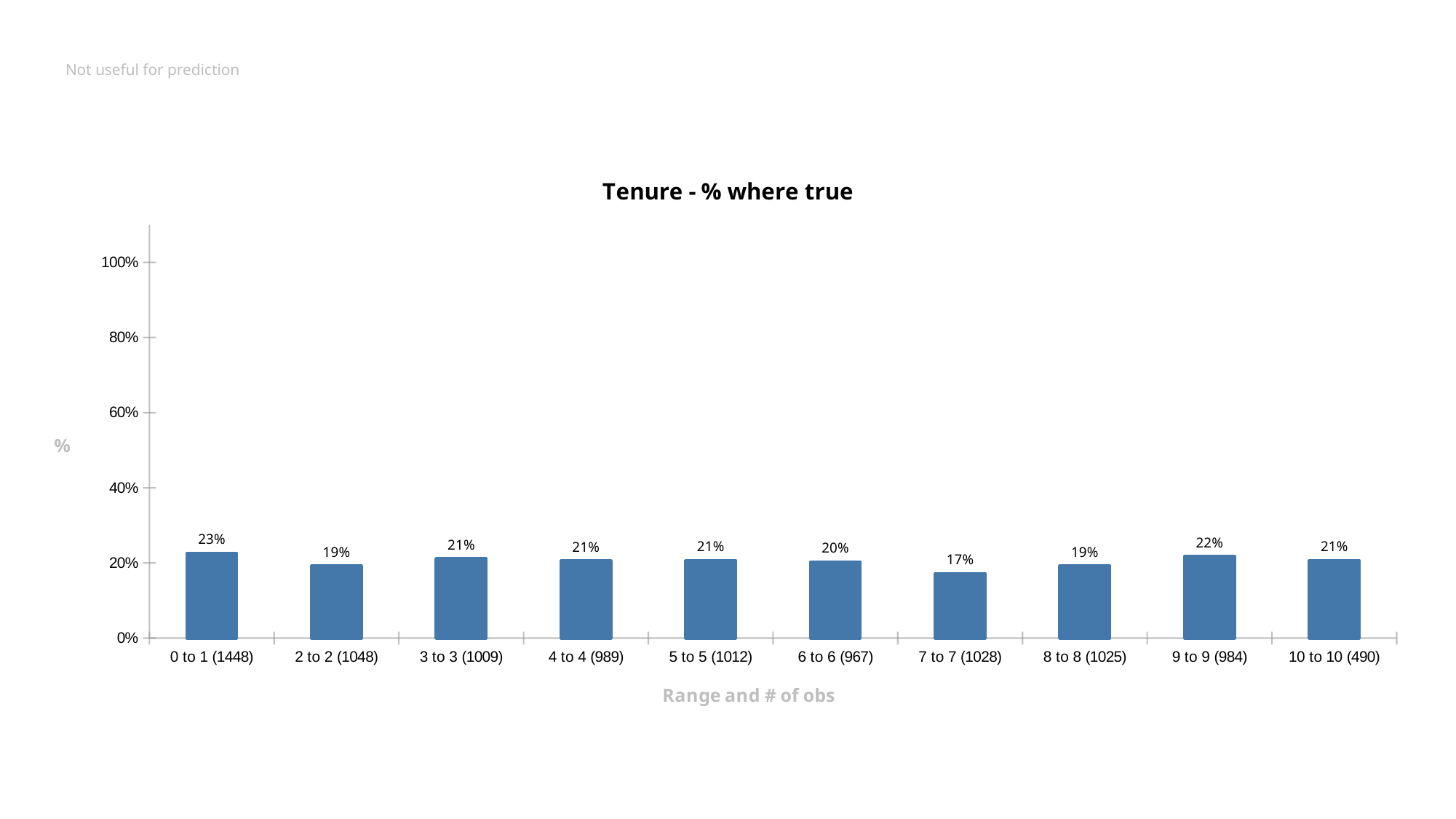
What is the value for the "9 to 9 (984)" category? 22% Is the value for "0 to 1 (1448)" greater or less than 40%? less What is the value for the "7 to 7 (1028)" category? 17% Which is larger, the value for "9 to 9 (984)" or the value for "8 to 8 (1025)"? 9 to 9 (984) Which category has the lowest value? 7 to 7 (1028) What is the title of the chart? Tenure - % where true What is the value for the "6 to 6 (967)" category? 20% What kind of chart is shown on the slide? bar chart What is the difference between the values for "0 to 1 (1448)" and "7 to 7 (1028)"? 6% What is the value for the "0 to 1 (1448)" category? 23% How many categories are shown on the x axis? 10 Which category has the highest value? 0 to 1 (1448)